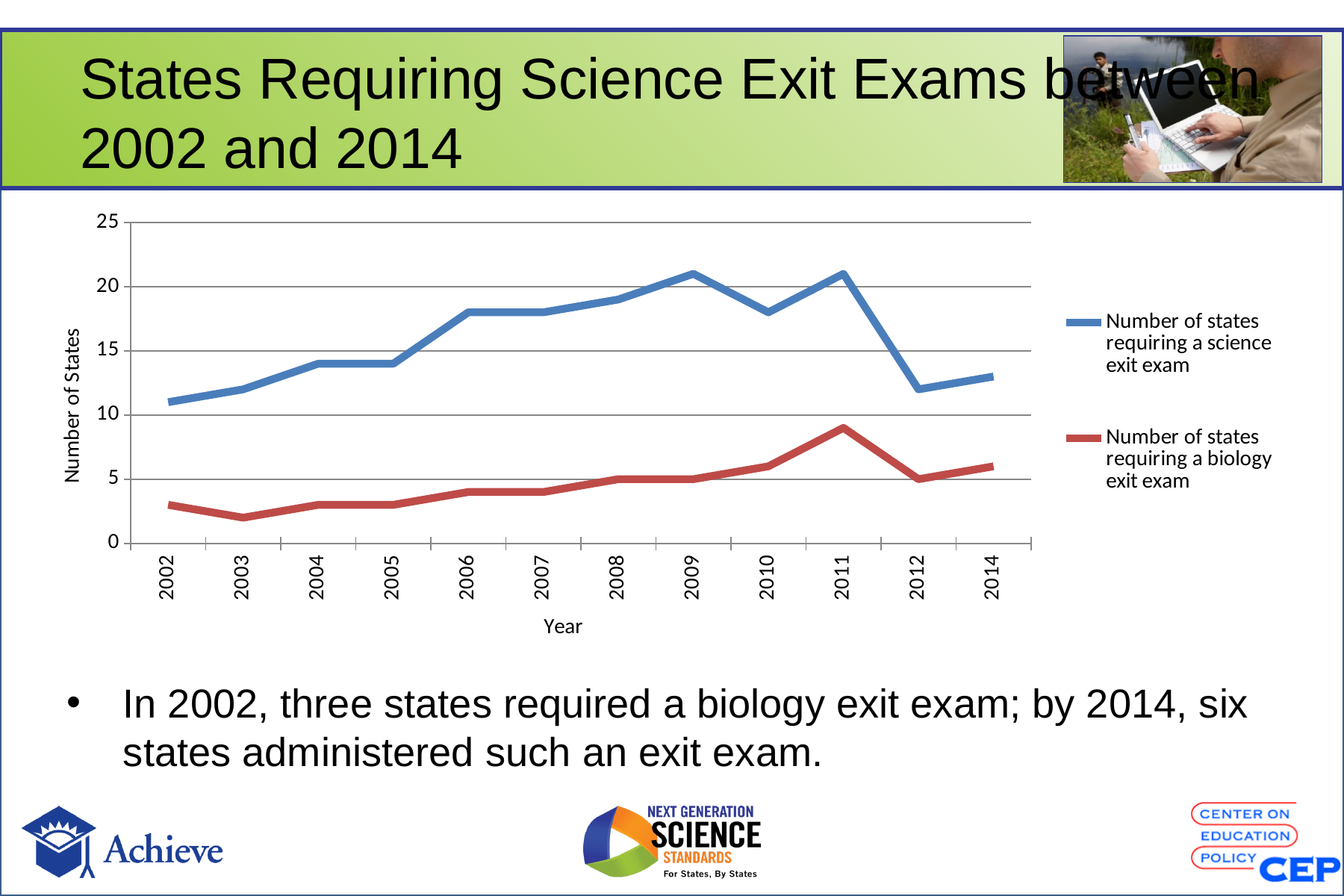
By how much did the number of states requiring a biology exit exam increase from 2002 to 2014? 3 In 2009, which series has the larger value: states requiring a science exit exam or states requiring a biology exit exam? Number of states requiring a science exit exam In which year was the number of states requiring a biology exit exam lowest? 2003 Is the number of states requiring a science exit exam in 2012 greater or less than 15? less How many states required a biology exit exam in 2002? 3 What kind of chart is shown on the slide? line chart Did the number of states requiring a science exit exam rise or fall between 2011 and 2012? fall How many states required a biology exit exam in 2014? 6 Is the number of states requiring a science exit exam in 2009 greater or less than 20? greater How many years are shown along the x axis? 12 In which year was the number of states requiring a biology exit exam highest? 2011 How many series does the legend list? 2